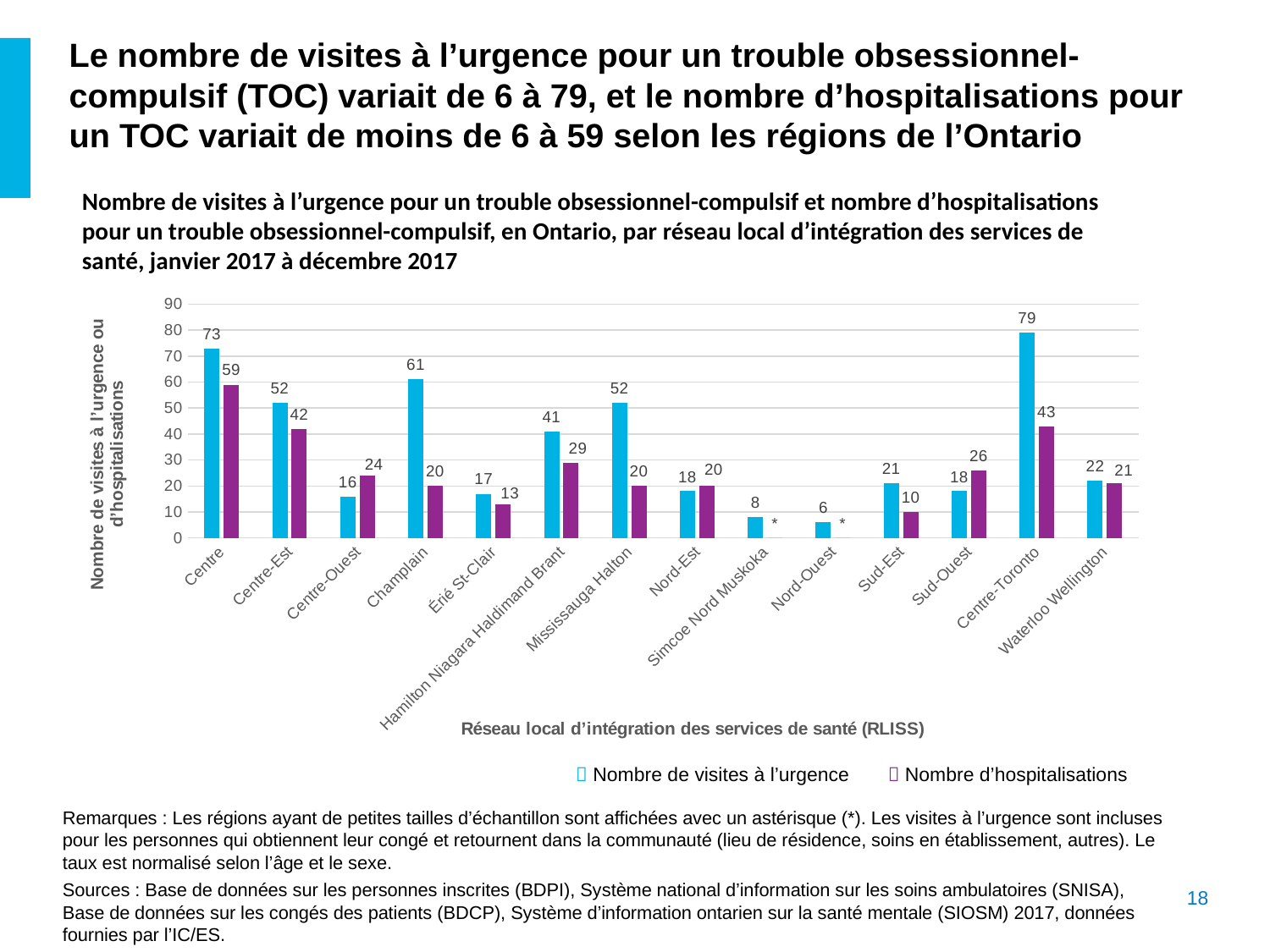
How many regions (RLISS) are shown on the x axis? 14 What type of chart is shown on the slide? Bar chart What is the difference in emergency department visits between Centre and Centre-Est? 21 What is the number of hospitalisations for Sud-Ouest? 26 Which is larger for Centre-Ouest: the number of emergency department visits or the number of hospitalisations? Nombre d'hospitalisations What is the number of hospitalisations (Nombre d'hospitalisations) for Centre? 59 What symbol is shown instead of a hospitalisation value for Simcoe Nord Muskoka and Nord-Ouest? * What is the difference between emergency department visits and hospitalisations for Champlain? 41 Which region has the highest number of emergency department visits? Centre-Toronto How many emergency department visits (Nombre de visites à l'urgence) are shown for Centre-Toronto? 79 How many series does the legend list? 2 Which region has the lowest number of emergency department visits? Nord-Ouest